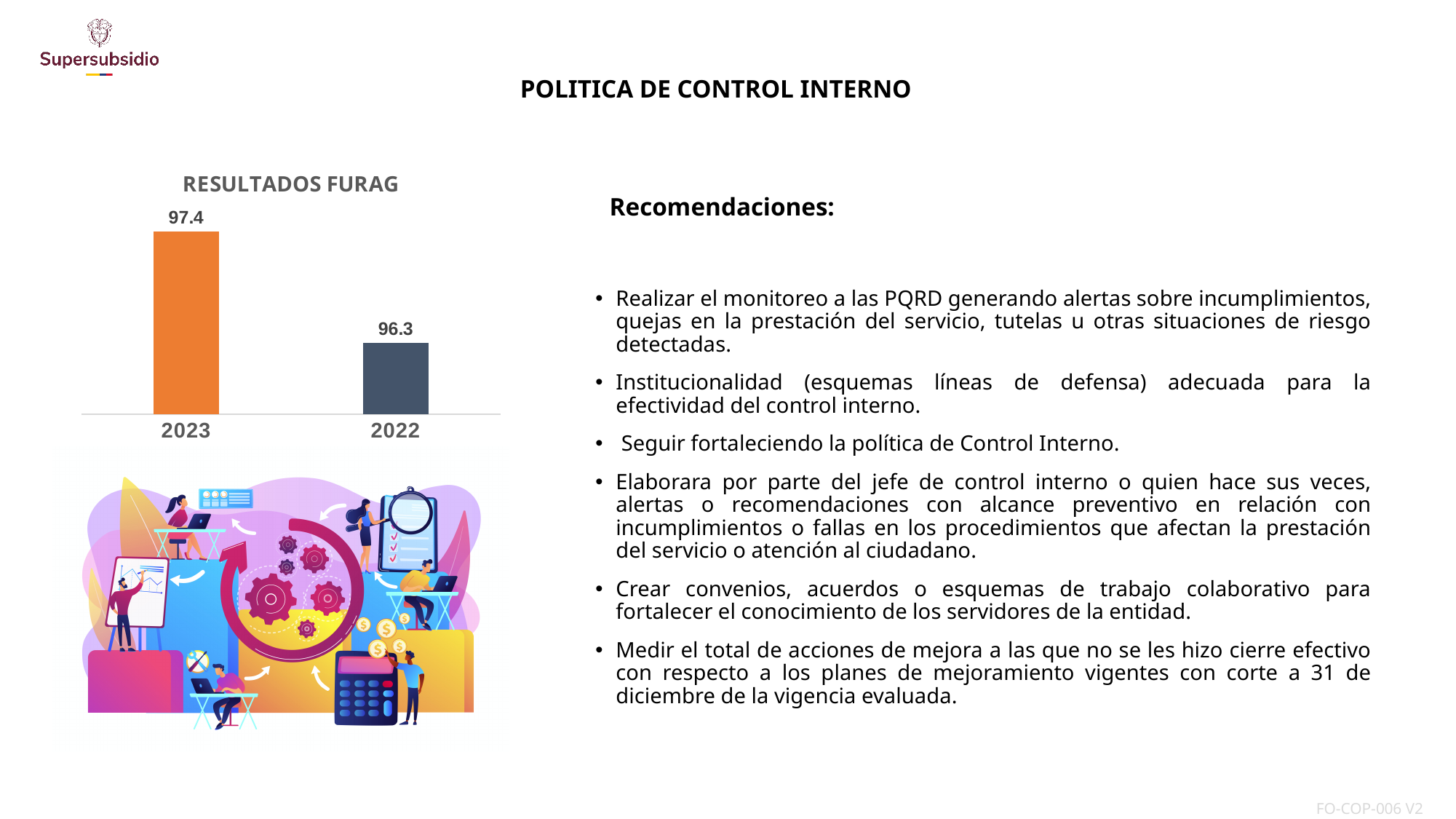
How many categories are shown in the RESULTADOS FURAG chart? 2 What is the value for 2022 in the RESULTADOS FURAG chart? 96.3 Which year has the highest value in the RESULTADOS FURAG chart? 2023 What is the title of the chart on the slide? RESULTADOS FURAG What kind of chart is the RESULTADOS FURAG chart? bar chart In the RESULTADOS FURAG chart, is the value for 2023 larger or smaller than the value for 2022? larger Which year has the lowest value in the RESULTADOS FURAG chart? 2022 What is the value for 2023 in the RESULTADOS FURAG chart? 97.4 What is the difference between the 2023 and 2022 values in the RESULTADOS FURAG chart? 1.1 What colour is the bar for 2023 in the RESULTADOS FURAG chart? orange